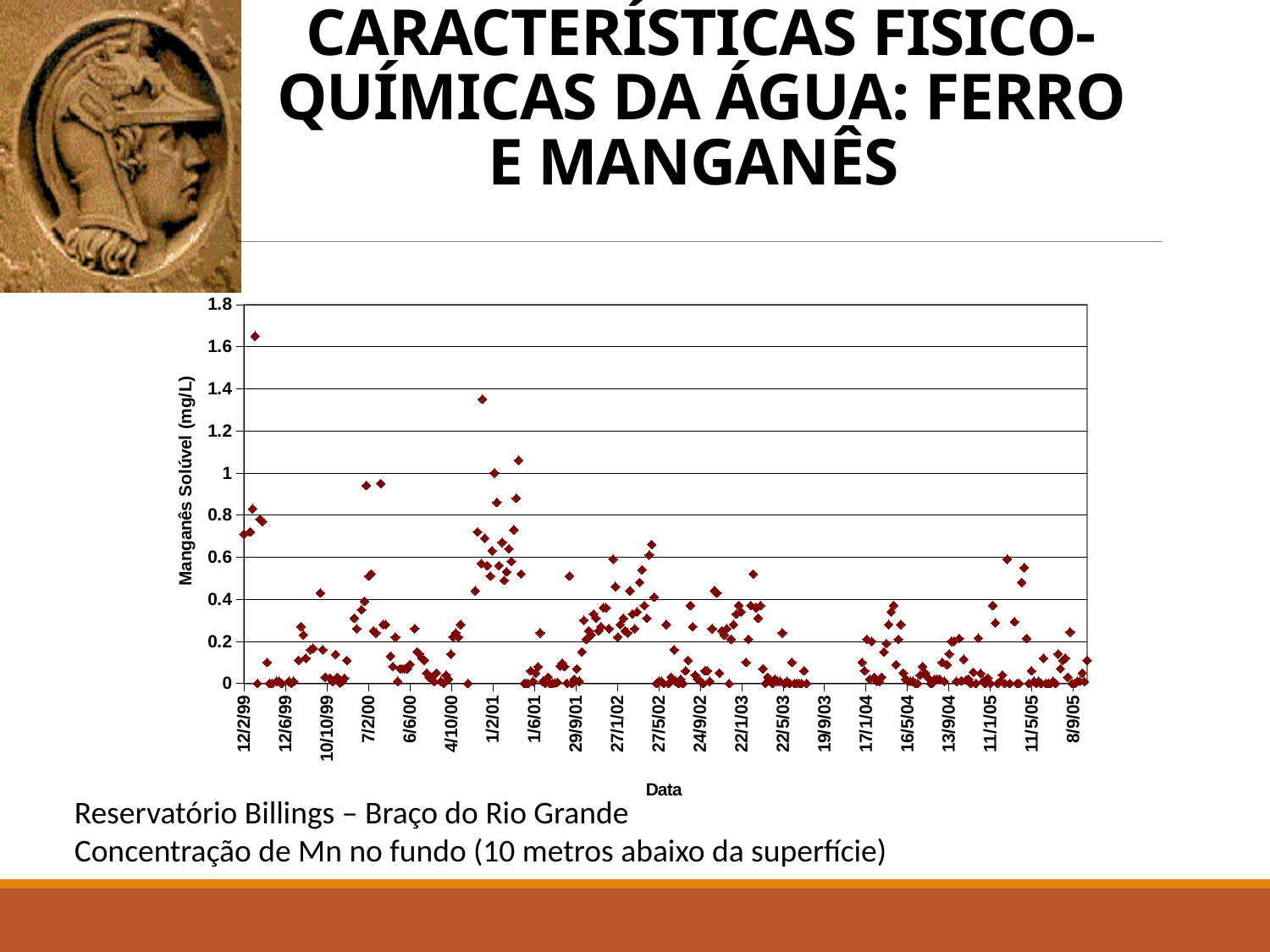
Is the highest point plotted near 11/1/05 greater or less than 0.8? less Do the peak manganese values generally rise or fall along the x axis from 1999 to 2005? fall What is the label of the x axis of the chart? Data How many date labels are shown along the x axis? 21 Is the highest point plotted near 1/2/01 greater or less than 1.2? greater What is the highest tick value shown on the y axis? 1.8 What kind of chart is shown on the slide? scatter chart Is the highest plotted manganese value greater or less than 1.4? greater What is the label of the y axis of the chart? Manganês Solúvel (mg/L) What is the first date label on the x axis? 12/2/99